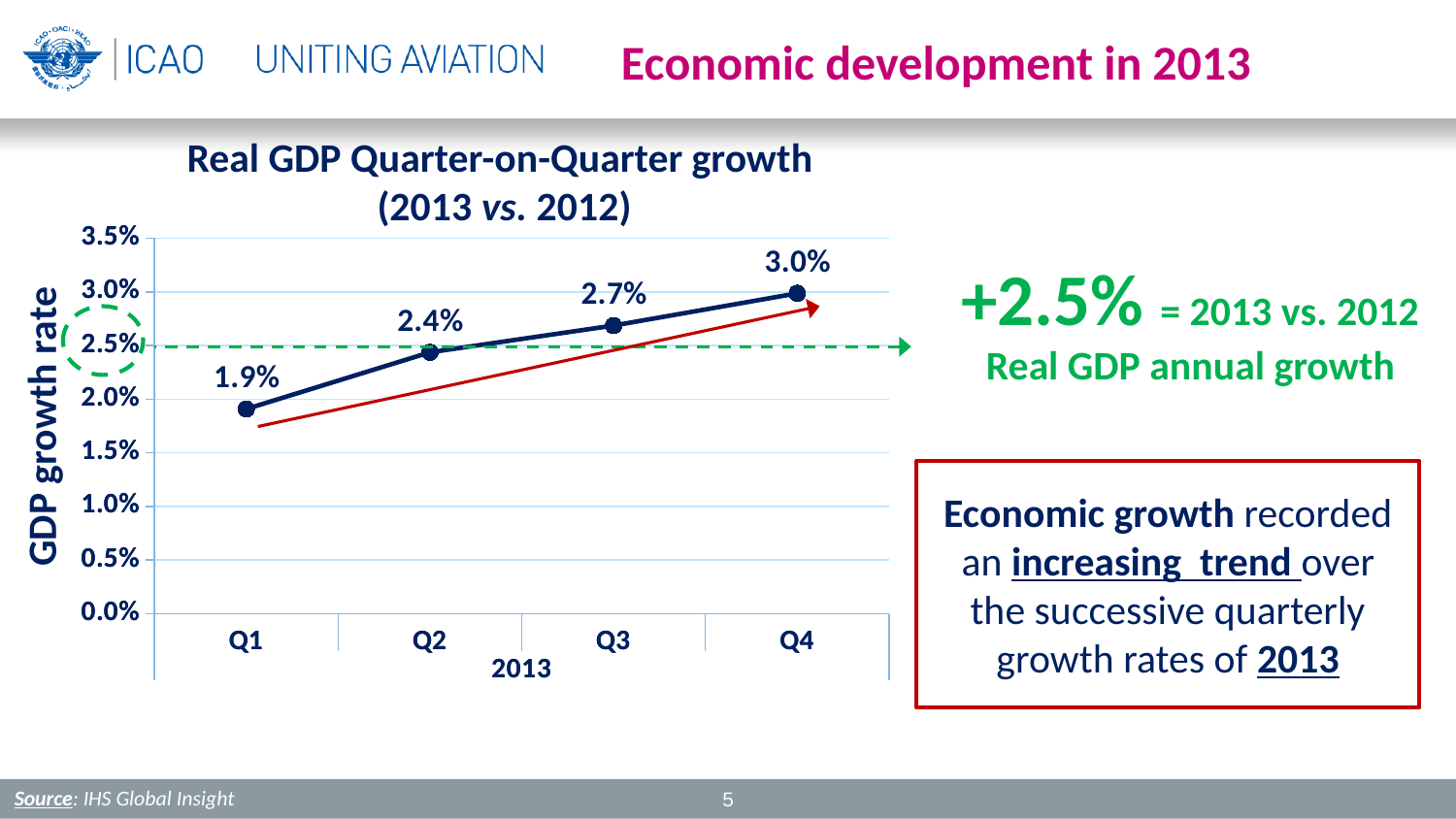
What is the Real GDP quarter-on-quarter growth rate for Q1 2013? 1.9% What is the label of the vertical axis of the chart? GDP growth rate What is the difference between the Q4 and Q1 growth rates? 1.1% Which quarter has the highest GDP growth rate in the chart? Q4 What is the difference between the Q2 and Q1 growth rates? 0.5% What is the Real GDP quarter-on-quarter growth rate for Q4 2013? 3.0% Which quarter has the lowest GDP growth rate in the chart? Q1 Which quarter has a higher growth rate, Q2 or Q3? Q3 How many quarters are plotted in the chart? 4 Do the quarterly growth rates rise or fall from Q1 to Q4 in 2013? Rise What kind of chart is used to show Real GDP quarter-on-quarter growth? Line chart What is the Real GDP quarter-on-quarter growth rate for Q3 2013? 2.7%